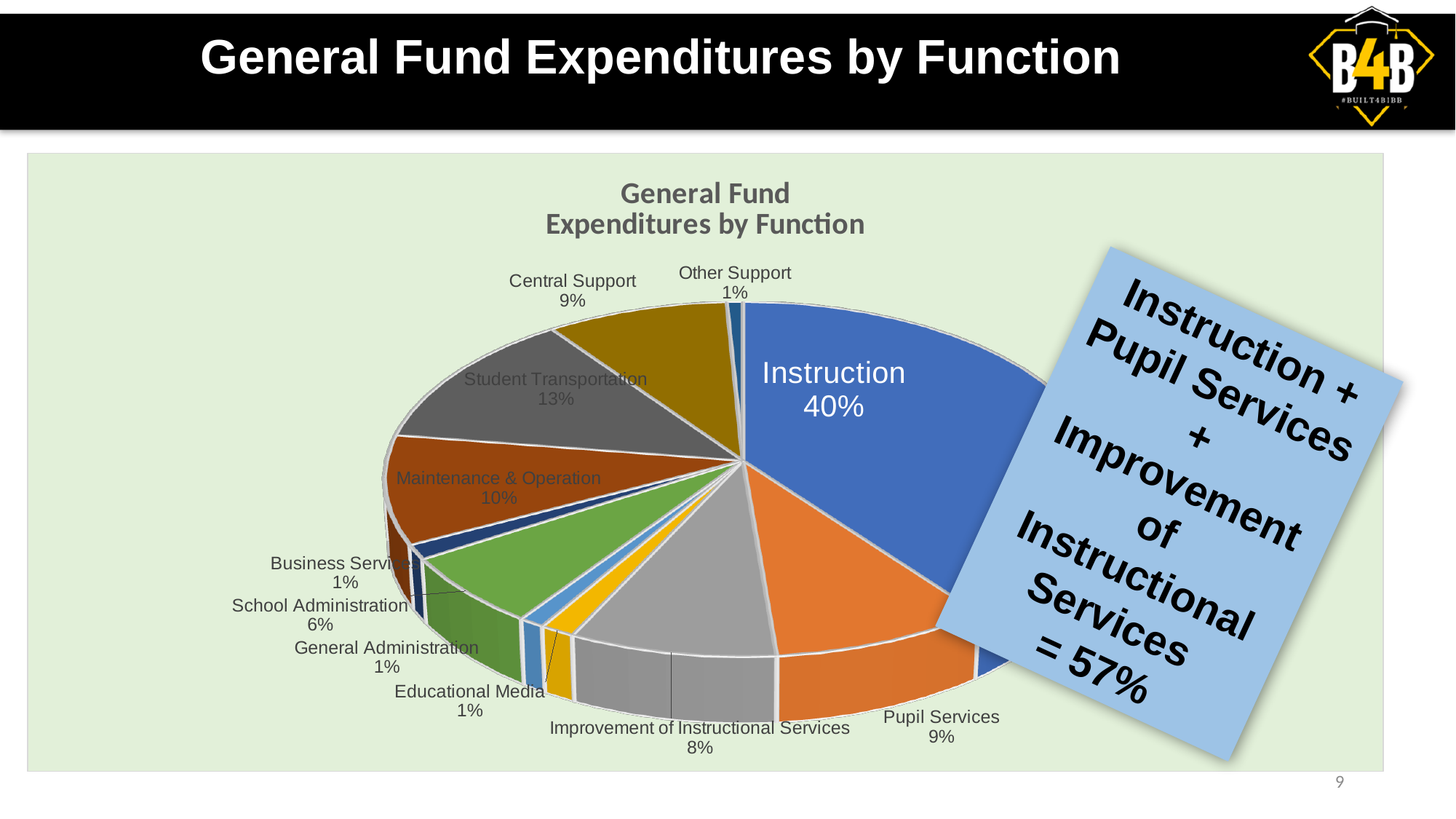
What is the difference between the Instruction share and the Pupil Services share? 31% According to the callout box, what is the combined share of Instruction, Pupil Services and Improvement of Instructional Services? 57% How many slices does the pie chart have? 11 What type of chart is shown on the slide? Pie chart What percentage is shown for Improvement of Instructional Services? 8% Which is larger, the share for Student Transportation or the share for Central Support? Student Transportation What share of General Fund expenditures goes to Instruction? 40% What is the difference between the Maintenance & Operation share and the Improvement of Instructional Services share? 2% What percentage is shown for School Administration? 6% Which function has the largest share of expenditures? Instruction What percentage is shown for Maintenance & Operation? 10% What percentage is shown for Student Transportation? 13%